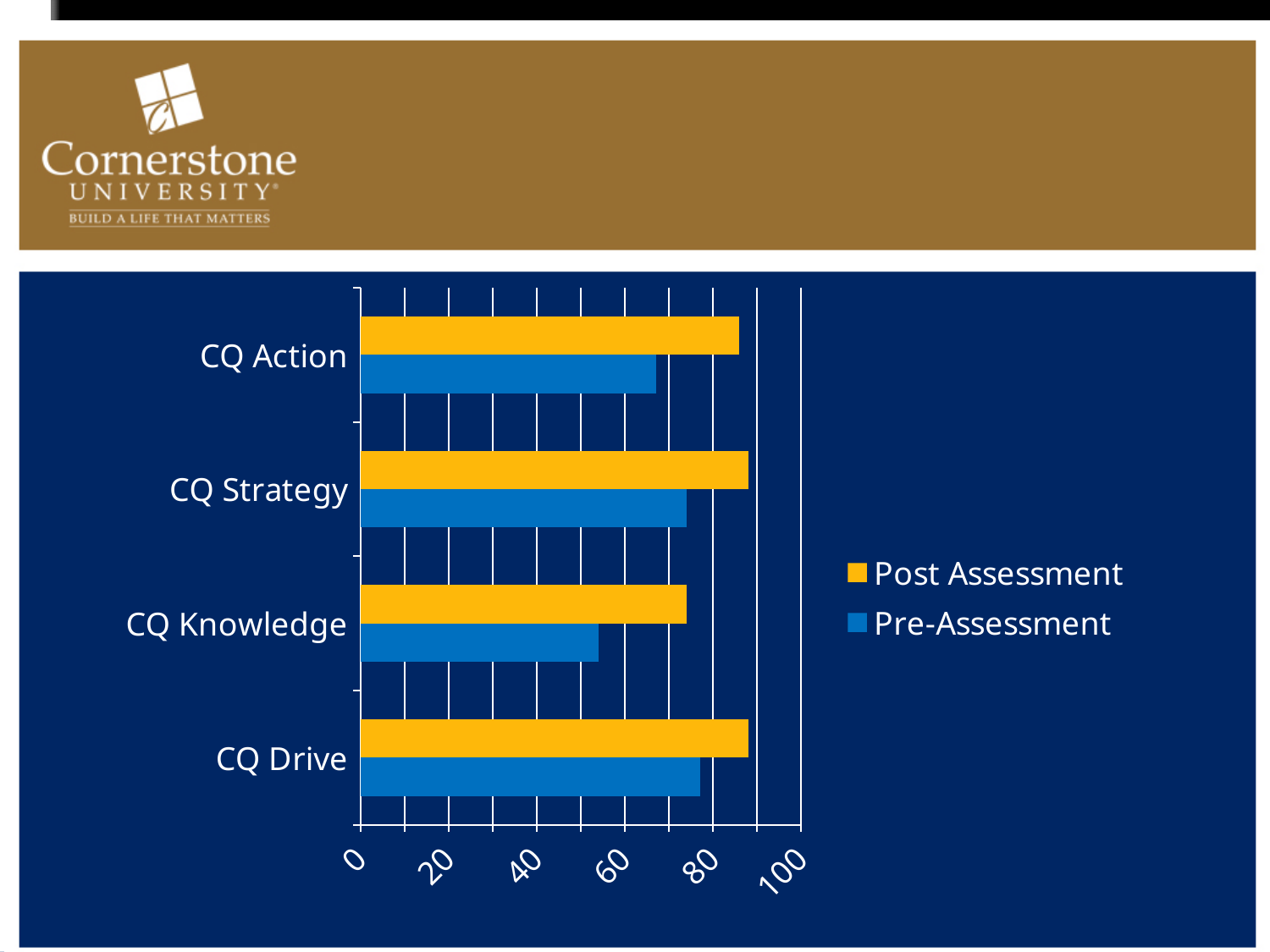
Which colour represents the Post Assessment series? yellow How many series does the legend list? 2 Is the Pre-Assessment value for CQ Action greater or less than 80? less For CQ Action, which is larger: the Post Assessment value or the Pre-Assessment value? Post Assessment Is the Post Assessment value for CQ Knowledge greater or less than 60? greater Which category has the lowest Post Assessment value? CQ Knowledge What kind of chart is shown on the slide? bar chart How many categories are shown on the chart? 4 Which category has the lowest Pre-Assessment value? CQ Knowledge Is the Post Assessment value for CQ Action greater or less than 80? greater Which is larger: the Pre-Assessment value for CQ Action or the Pre-Assessment value for CQ Knowledge? CQ Action